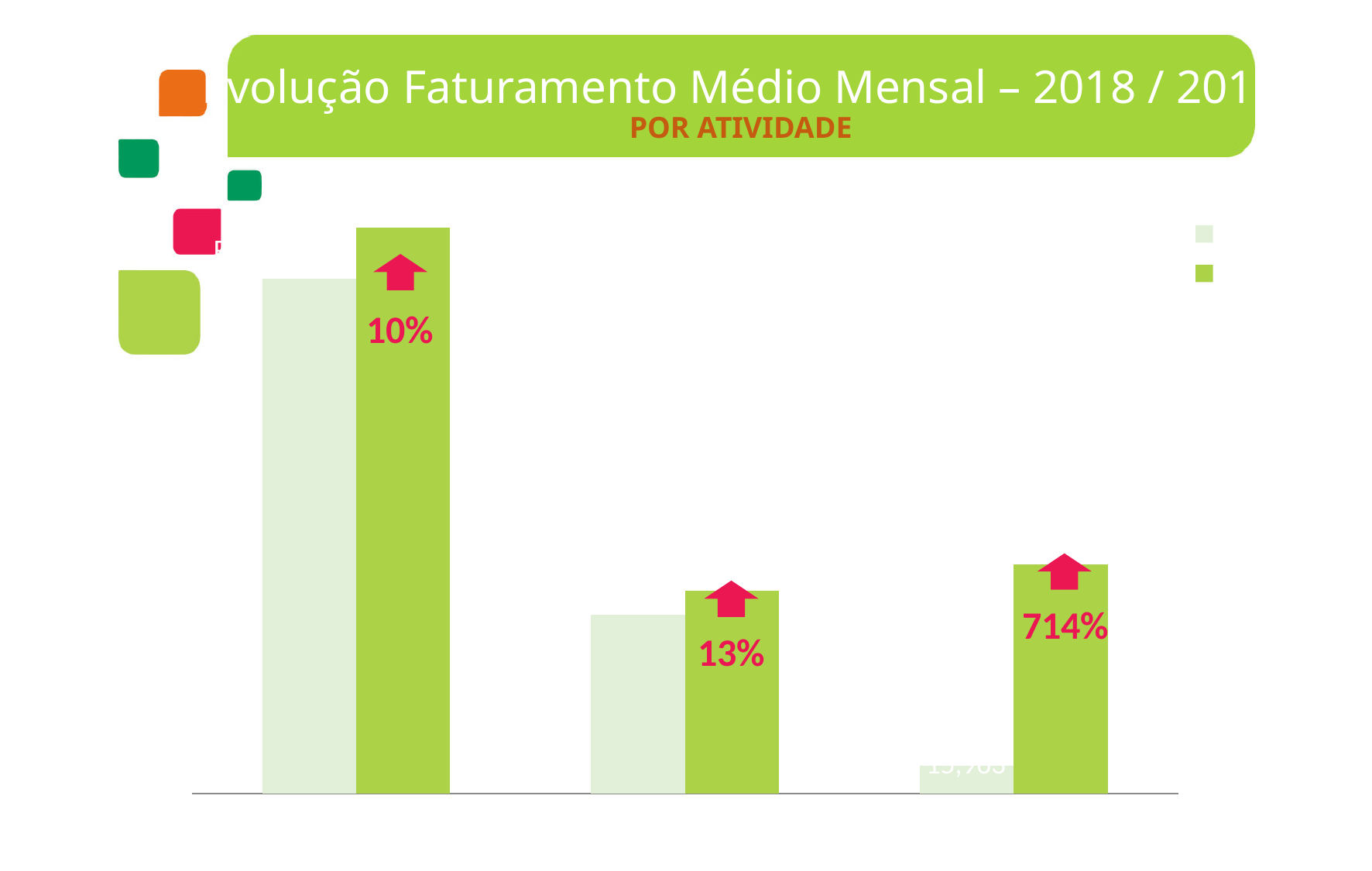
Which group of bars shows the smallest percentage change? the leftmost group (10%) How many bars are in each group of the chart? 2 What percentage change is labelled on the middle group of bars? 13% Which group of bars shows the largest percentage change? the rightmost group (714%) Which group of bars has the tallest bars in the chart? the leftmost group What kind of chart is shown on the slide? bar chart What percentage change is labelled on the leftmost group of bars? 10% In the rightmost group, which bar is taller, the light green bar or the dark green bar? the dark green bar In the leftmost group, is the dark green bar taller or shorter than the light green bar? taller What percentage change is labelled on the rightmost group of bars? 714% What subtitle appears in orange below the chart title? POR ATIVIDADE How many groups of bars are plotted in the chart? 3